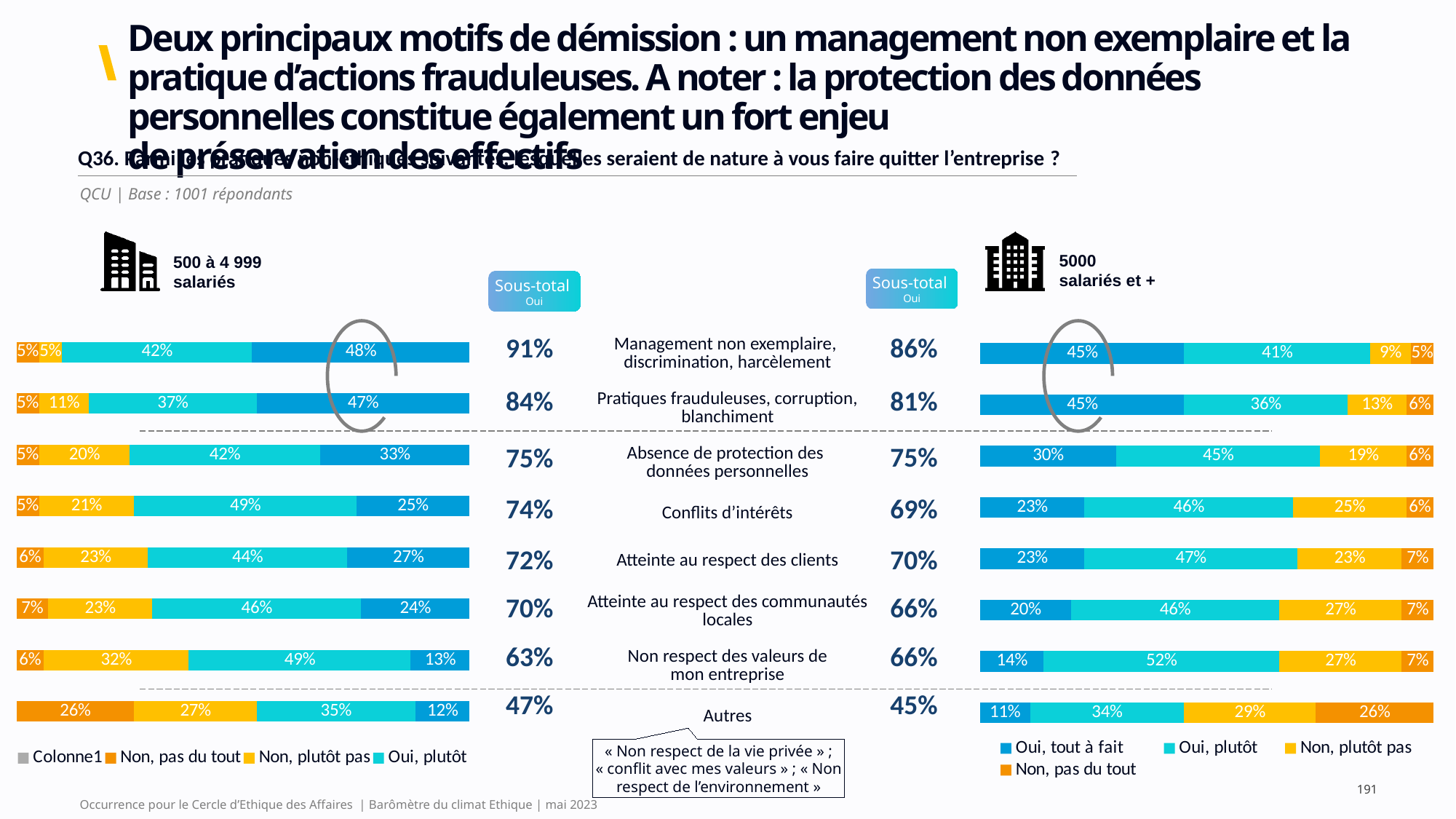
In the left chart (500 à 4 999 salariés), what is the difference between the 'Oui, plutôt' values for 'Non respect des valeurs de mon entreprise' and 'Pratiques frauduleuses, corruption, blanchiment'? 12% How many categories are plotted in the left chart (500 à 4 999 salariés)? 8 In the right chart (5000 salariés et +), what is the total of the 'Oui, tout à fait' and 'Oui, plutôt' segments for 'Conflits d'intérêts'? 69% In the right chart (5000 salariés et +), which category has the lowest 'Oui, tout à fait' value? Autres In the right chart (5000 salariés et +), what is the 'Non, pas du tout' value for 'Autres'? 26% What is the first legend entry listed under the left chart (500 à 4 999 salariés)? Colonne1 In the right chart (5000 salariés et +), which is larger: the 'Oui, plutôt' value for 'Non respect des valeurs de mon entreprise' or for 'Management non exemplaire, discrimination, harcèlement'? Non respect des valeurs de mon entreprise In the right chart (5000 salariés et +), what is the 'Oui, tout à fait' value for 'Absence de protection des données personnelles'? 30% What kind of chart is the right chart (5000 salariés et +)? Stacked bar chart How many series does the legend of the right chart (5000 salariés et +) list? 4 In the left chart (500 à 4 999 salariés), which category has the highest 'Non, pas du tout' value? Autres In the left chart (500 à 4 999 salariés), what is the 'Oui, plutôt' value for 'Conflits d'intérêts'? 49%